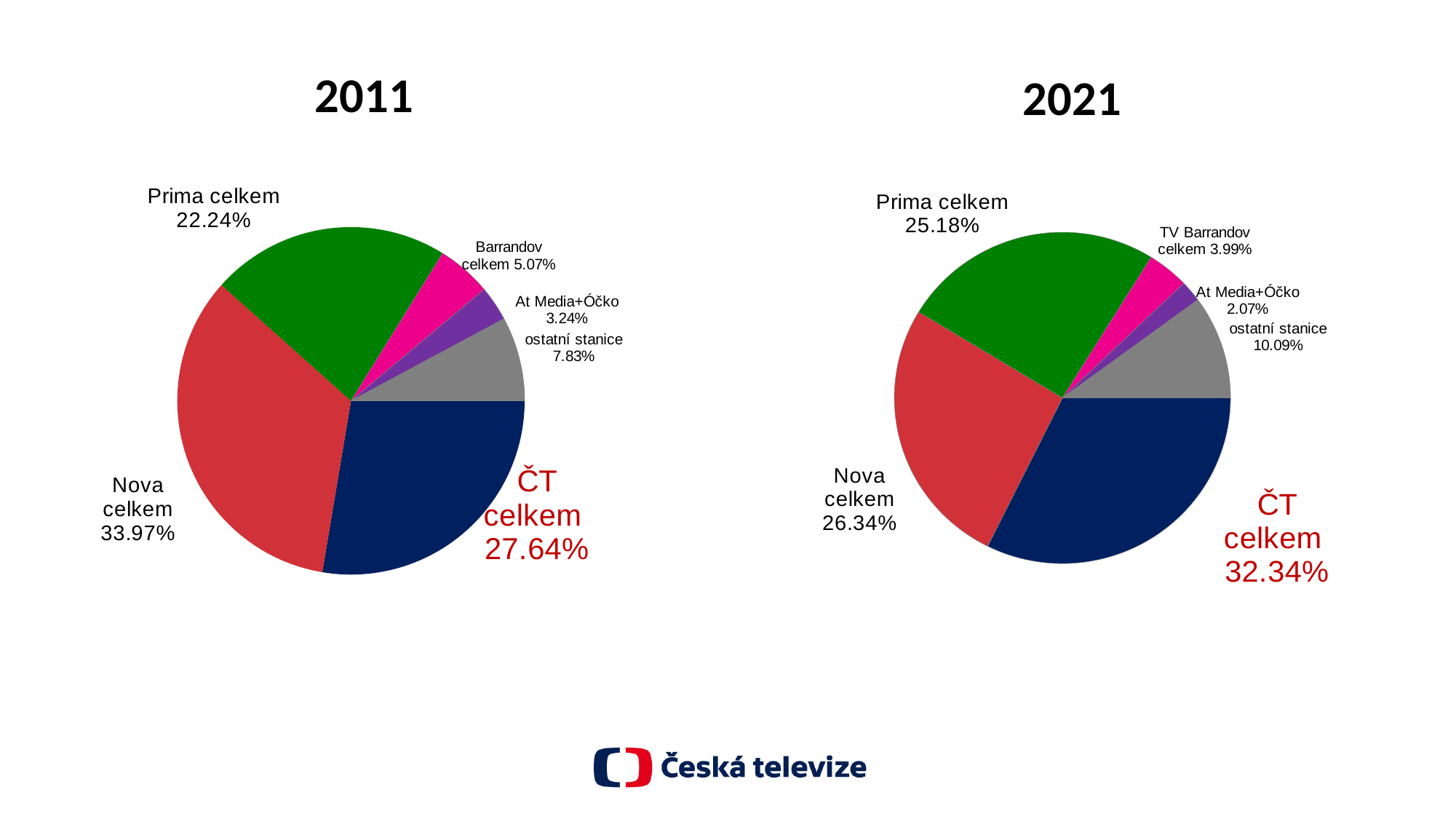
In the 2011 pie chart, which is larger: Prima celkem or ČT celkem? ČT celkem In the 2011 pie chart, which category has the smallest share? At Media+Óčko In the 2021 pie chart, what share does ostatní stanice have? 10.09% In the 2011 pie chart, which category has the largest share? Nova celkem In the 2011 pie chart, what share does Nova celkem have? 33.97% What is the difference between ČT celkem's share in 2021 and in 2011? 4.70% How many slices does the 2021 pie chart have? 6 In the 2021 pie chart, what share does ČT celkem have? 32.34% In the 2021 pie chart, which category has the largest share? ČT celkem In the 2011 pie chart, what share does At Media+Óčko have? 3.24% What type of chart is used on this slide? Pie chart In the 2021 pie chart, which category has the smallest share? At Media+Óčko